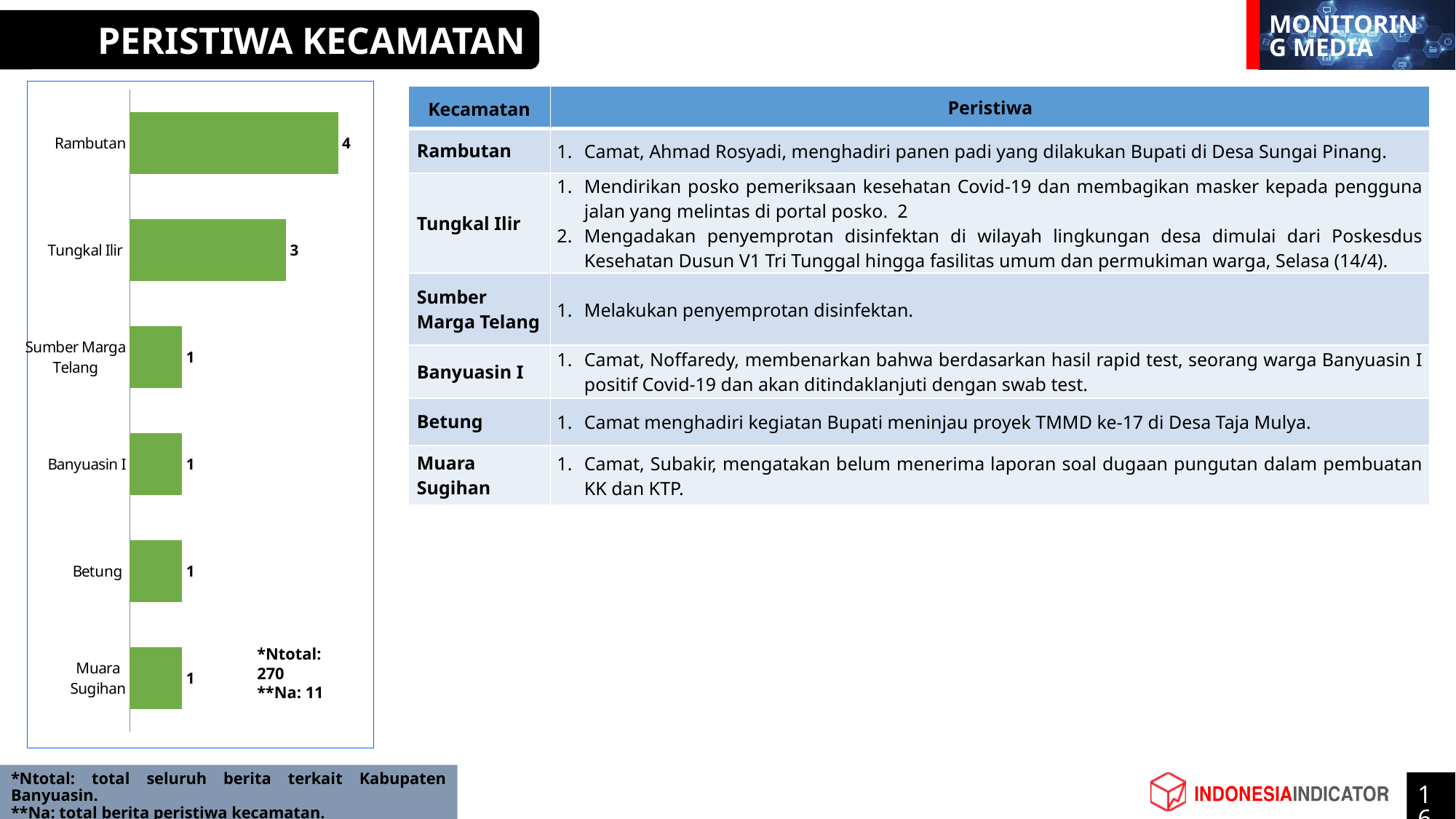
What is the value for Sumber Marga Telang in the bar chart? 1 What is the value for Rambutan in the bar chart? 4 What is the difference between the values for Tungkal Ilir and Betung? 2 Which kecamatan has the highest value in the bar chart? Rambutan How many kecamatan in the bar chart have a value of 1? 4 What is the value for Muara Sugihan in the bar chart? 1 How many kecamatan categories are shown in the bar chart? 6 Which is larger, the value for Tungkal Ilir or the value for Banyuasin I? Tungkal Ilir What is the difference between the values for Rambutan and Tungkal Ilir? 1 What is the Ntotal value noted on the chart? 270 What kind of chart is shown on the slide? bar chart What is the value for Tungkal Ilir in the bar chart? 3